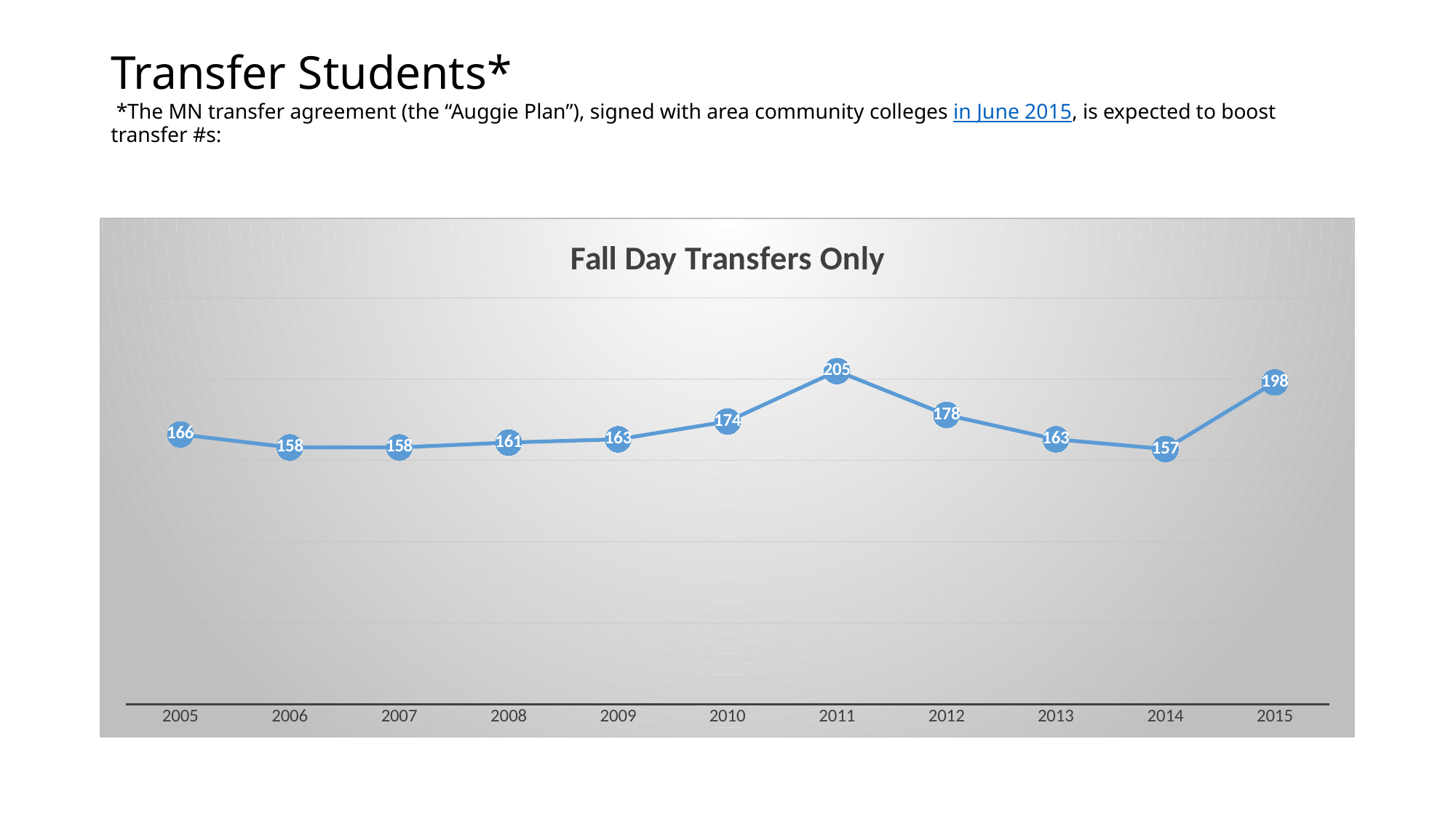
Do the values rise or fall from 2011 to 2014? fall What is the value for 2005? 166 Which is larger, the value for 2010 or the value for 2012? 2012 What is the difference between the values for 2011 and 2014? 48 Which year has the highest value? 2011 Which year has the lowest value? 2014 How many years are plotted on the chart? 11 What is the difference between the values for 2015 and 2014? 41 What is the value for 2011? 205 What kind of chart is shown? line chart What is the title of the chart? Fall Day Transfers Only What is the value for 2015? 198